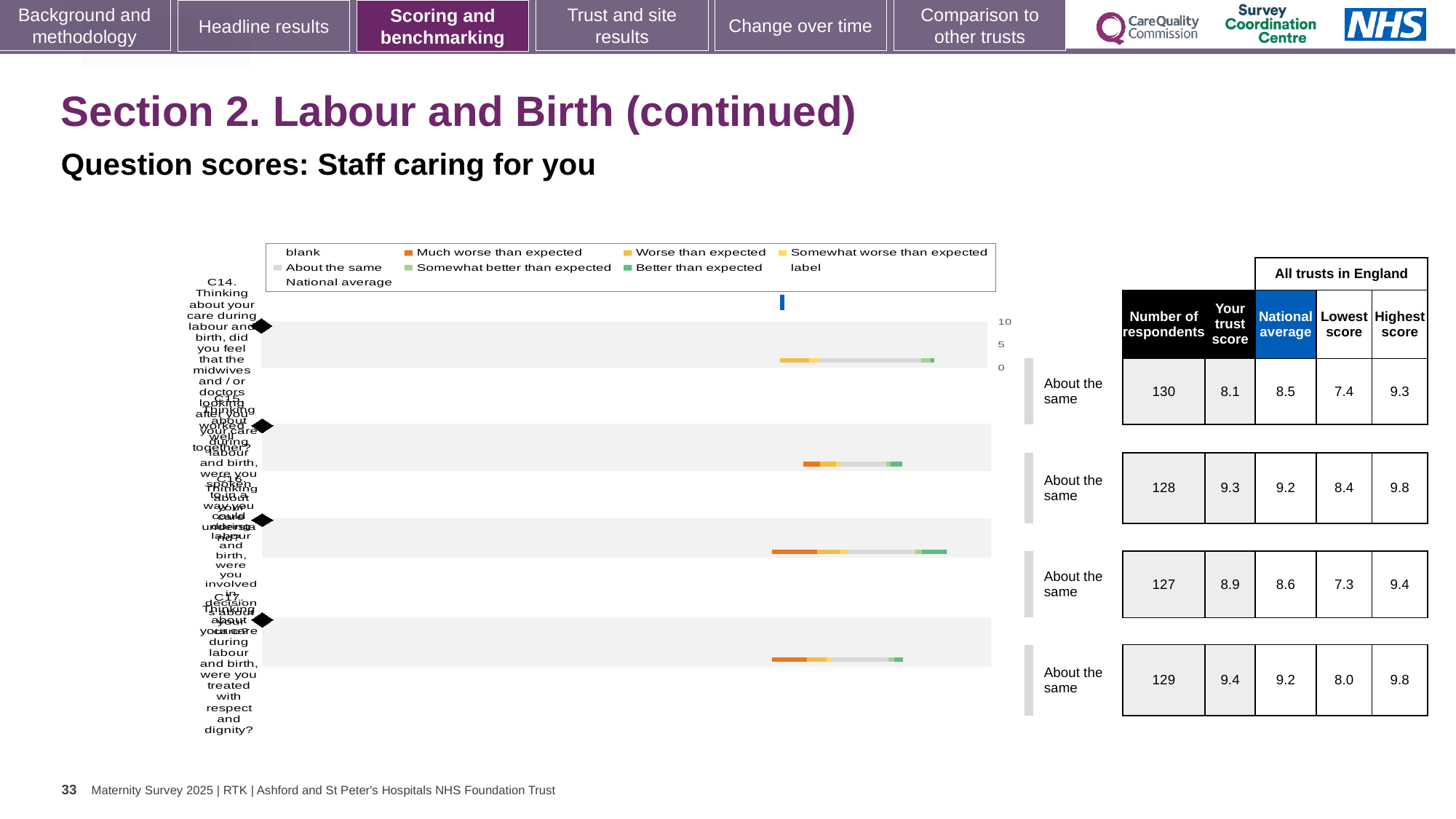
Which question has the lowest trust score in the table beside the chart? C14 What benchmark label is shown beside each of the four bars? About the same For question C16, which is larger: the trust score or the national average? trust score For question C14, what is the difference between the national average and the trust score? 0.4 In the table beside the chart, what is the trust score for question C15? 9.3 Which question has the highest trust score in the table beside the chart? C17 In the table beside the chart, what is the lowest score for question C16? 7.3 In the table beside the chart, what is the number of respondents for question C14? 130 What kind of chart is shown on the slide? bar chart How many question bars (C14 to C17) are plotted in the chart? 4 In the table beside the chart, what is the national average for question C17? 9.2 What heading appears above the chart? Question scores: Staff caring for you